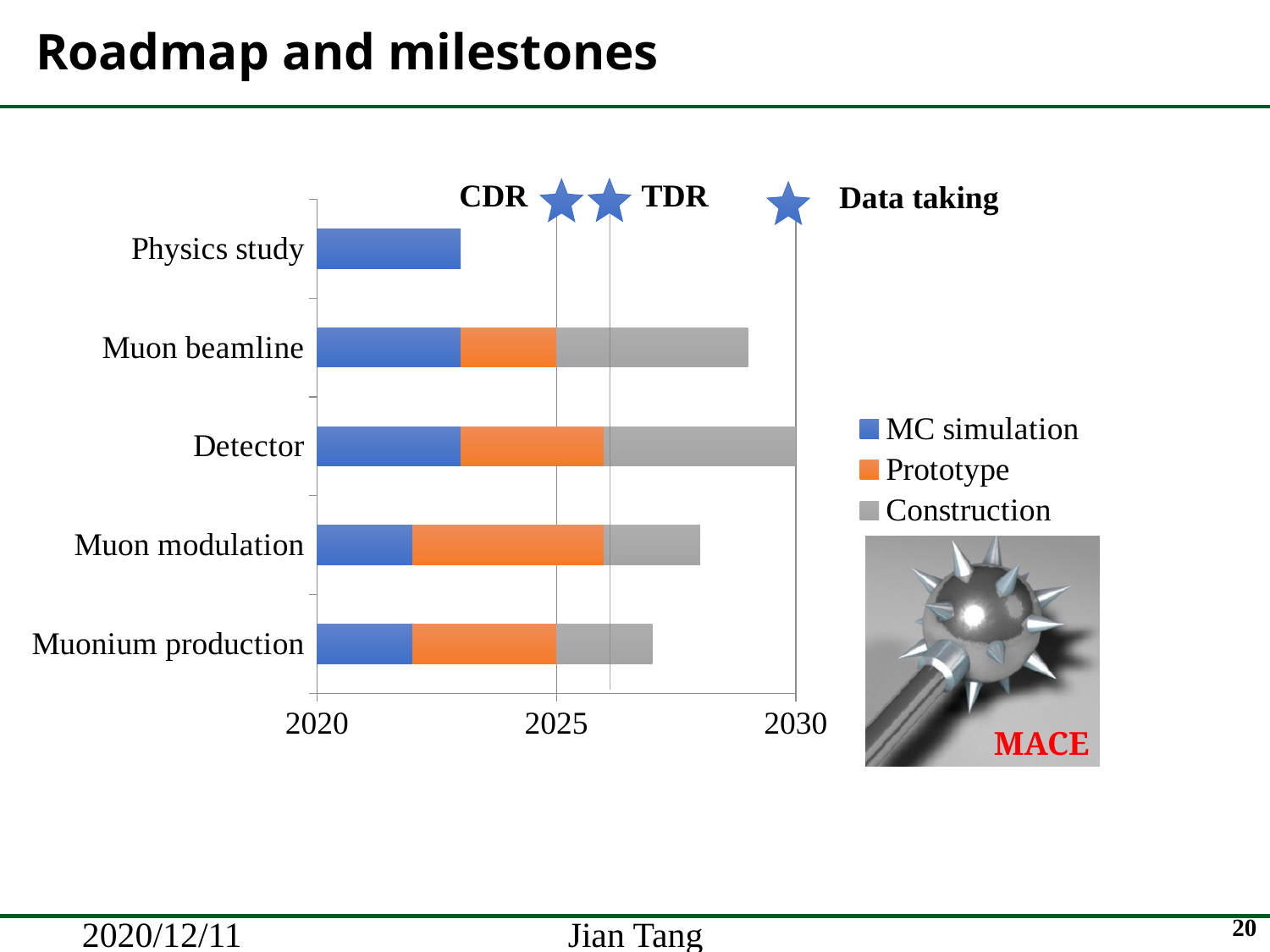
How many categories are listed on the vertical axis of the chart? 5 How many series does the chart legend list? 3 What kind of chart is shown on the slide? bar chart Which category's bar consists only of the MC simulation segment? Physics study Which bar extends further to the right: Muon modulation or Muonium production? Muon modulation Which category has the shortest bar? Physics study What are the three milestones marked with stars above the chart? CDR, TDR, Data taking Which category's bar extends furthest to the right along the year axis? Detector In which year does the Detector bar end? 2030 Does the Muon beamline bar end before or after 2025? after Does the Physics study bar end before or after 2025? before What colour represents the Prototype series in the legend? orange